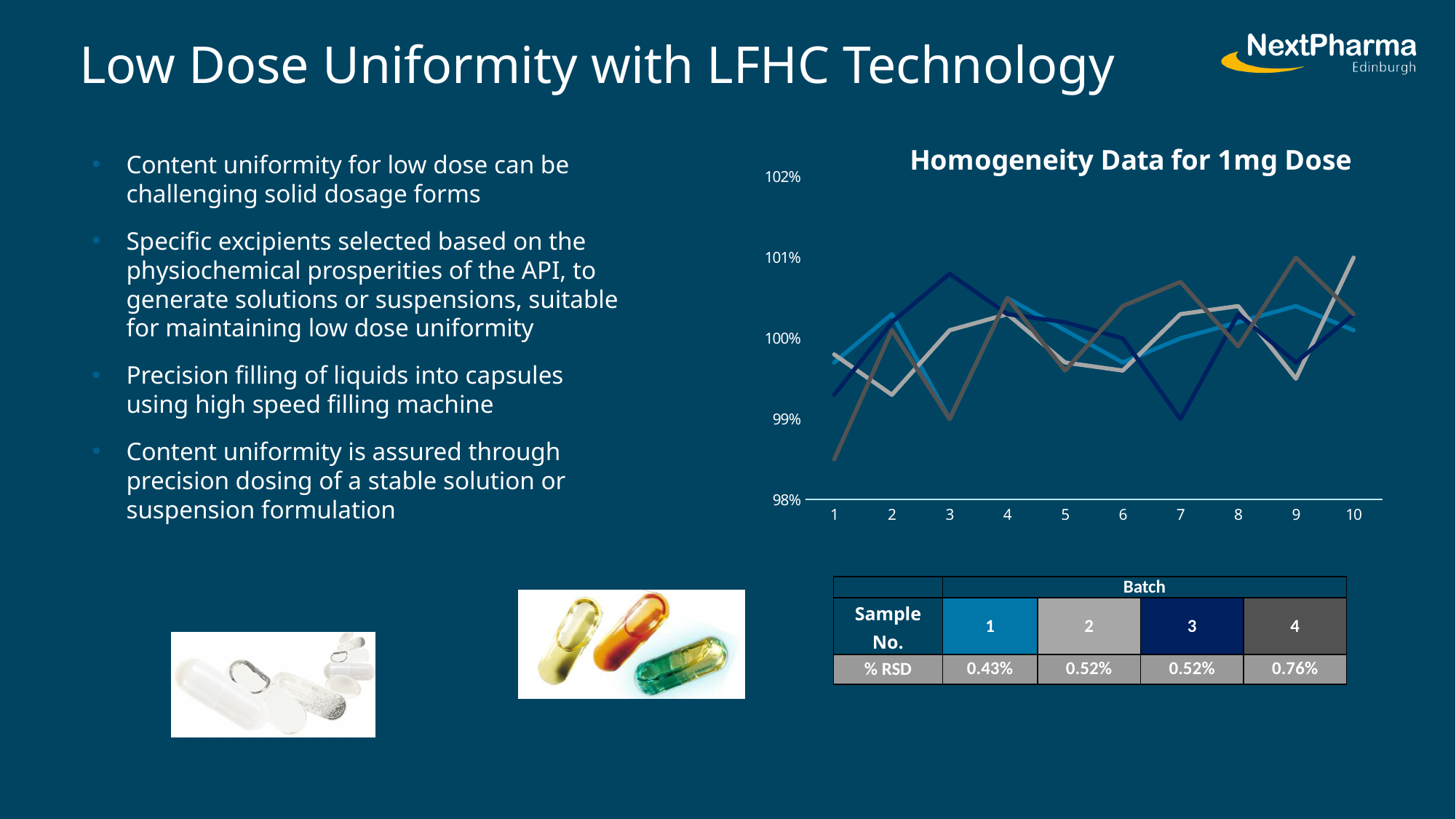
Is the value for Batch 1 (light blue line) at sample 1 greater or less than 100%? less What is the lowest value shown on the chart's y axis? 98% Is the value for Batch 3 (dark navy line) at sample 3 greater or less than 100%? greater What kind of chart is shown on the slide? line chart What is the title of the chart? Homogeneity Data for 1mg Dose Is the value for Batch 4 (dark gray line) at sample 1 greater or less than 99%? less How many sample numbers are shown along the x axis of the chart? 10 According to the table below the chart, what is the % RSD for Batch 1? 0.43% According to the table below the chart, which batch has the highest % RSD? 4 How many lines (batches) are plotted on the chart? 4